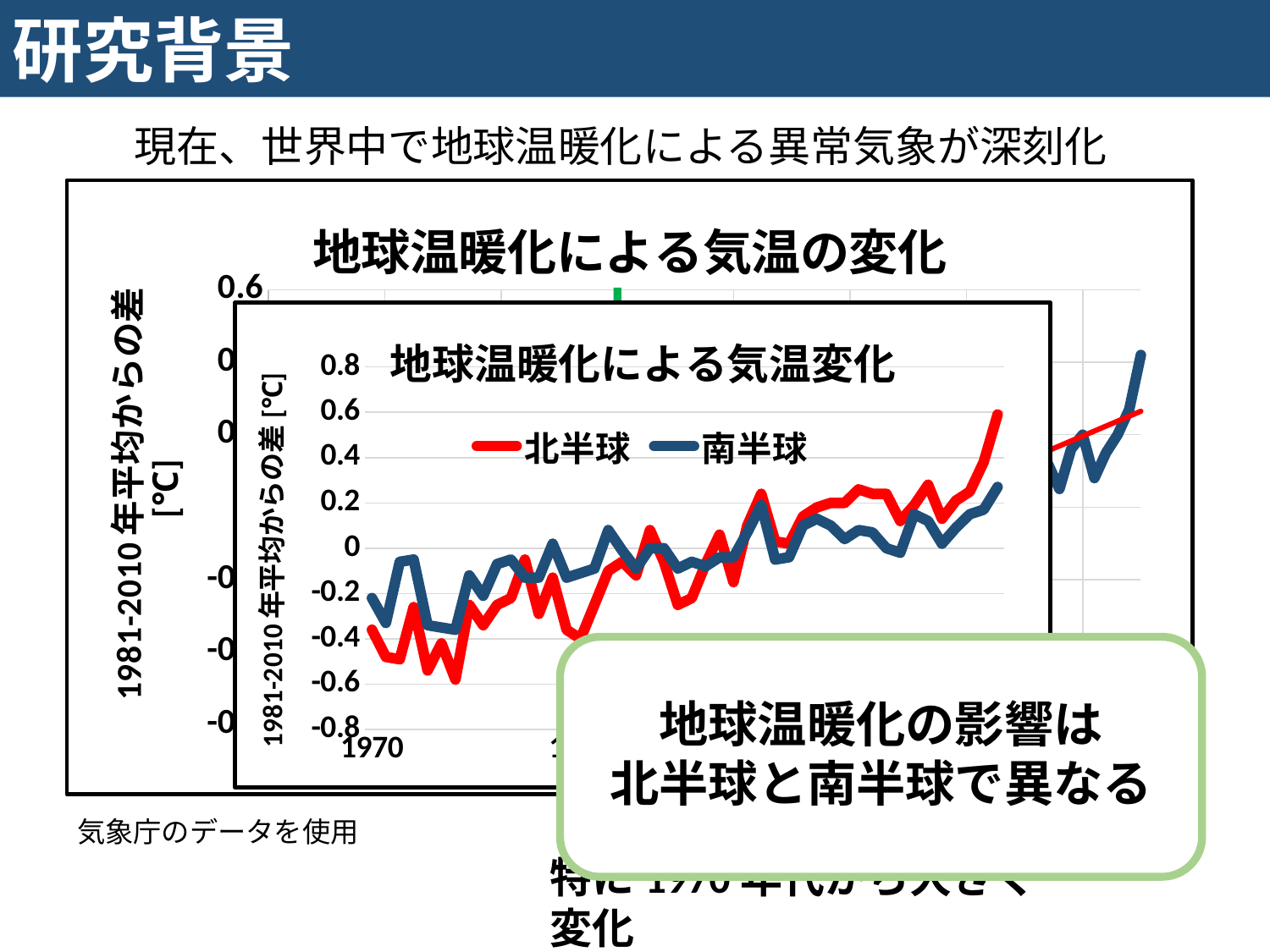
In the front chart 地球温暖化による気温変化, is the lowest value of the 北半球 series greater or less than -0.4? less In the front chart 地球温暖化による気温変化, do the values of the 南半球 series generally rise or fall from left to right? rise In the front chart 地球温暖化による気温変化, which series reaches the highest value on the chart? 北半球 In the front chart 地球温暖化による気温変化, at the rightmost end of the lines, which series has the larger value, 北半球 or 南半球? 北半球 In the front chart 地球温暖化による気温変化, is the final (rightmost) value of the 南半球 series greater or less than 0.4? less In the front chart 地球温暖化による気温変化, is the final (rightmost) value of the 北半球 series greater or less than 0.4? greater In the front chart 地球温暖化による気温変化, which series reaches the lowest value on the chart? 北半球 In the front chart 地球温暖化による気温変化, which series is drawn in red? 北半球 What kind of chart is the front chart titled 地球温暖化による気温変化? line chart In the front chart 地球温暖化による気温変化, how many series does the legend list? 2 In the front chart 地球温暖化による気温変化, do the values of the 北半球 series generally rise or fall from left to right? rise In the front chart 地球温暖化による気温変化, what are the two series named in the legend? 北半球 and 南半球